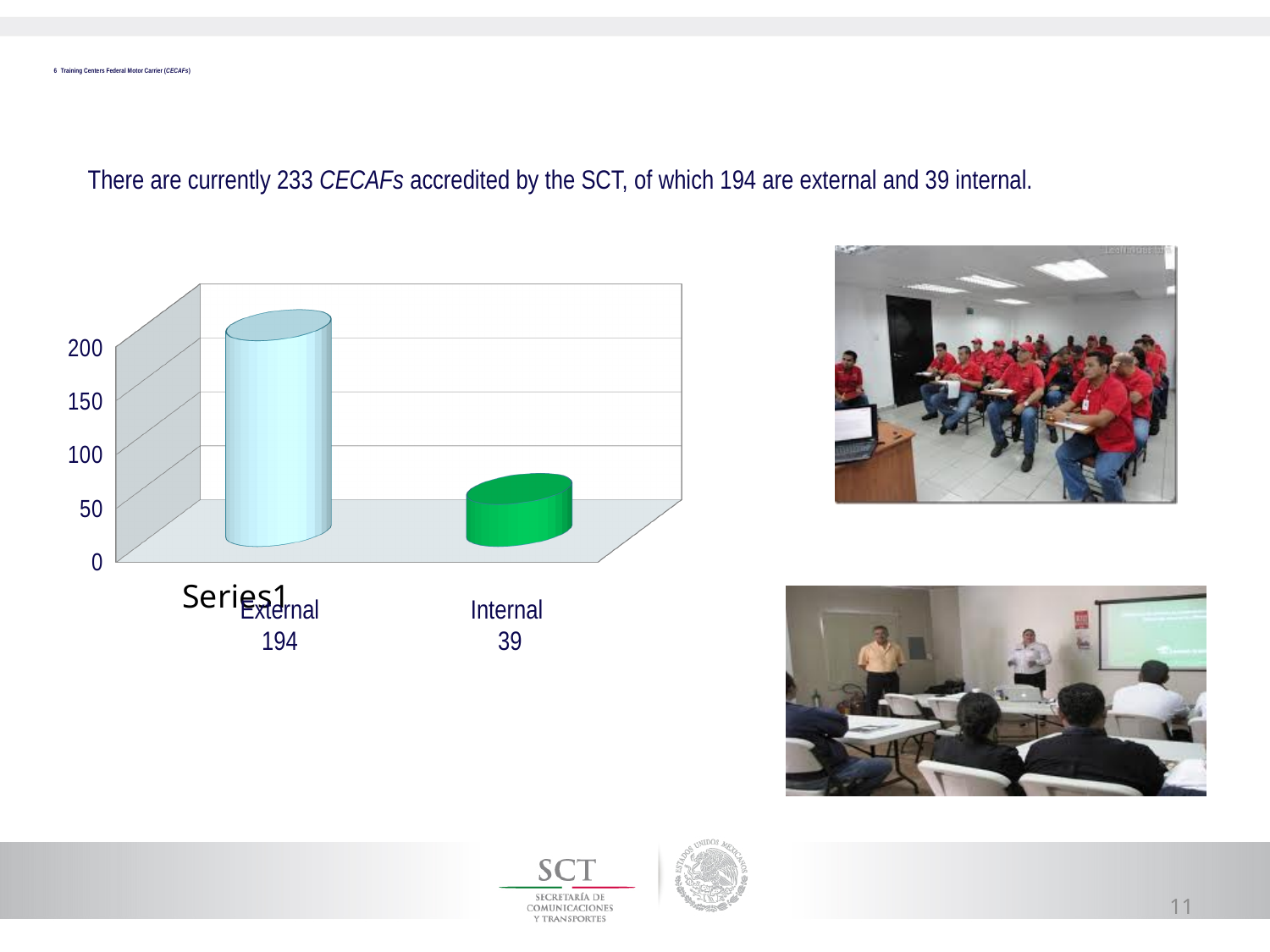
What kind of chart is shown on the slide? Bar chart How many categories are shown in the chart? 2 Which category has the highest value in the chart? External What is the value for Internal in the chart? 39 What is the value for External in the chart? 194 Is the value for Internal greater or less than 50? less What series name is printed below the chart's axis? Series1 Is the value for External greater or less than 150? greater Which is larger in the chart, External or Internal? External What is the difference between the External and Internal values in the chart? 155 Which category has the lowest value in the chart? Internal What is the highest value shown on the chart's vertical axis? 200